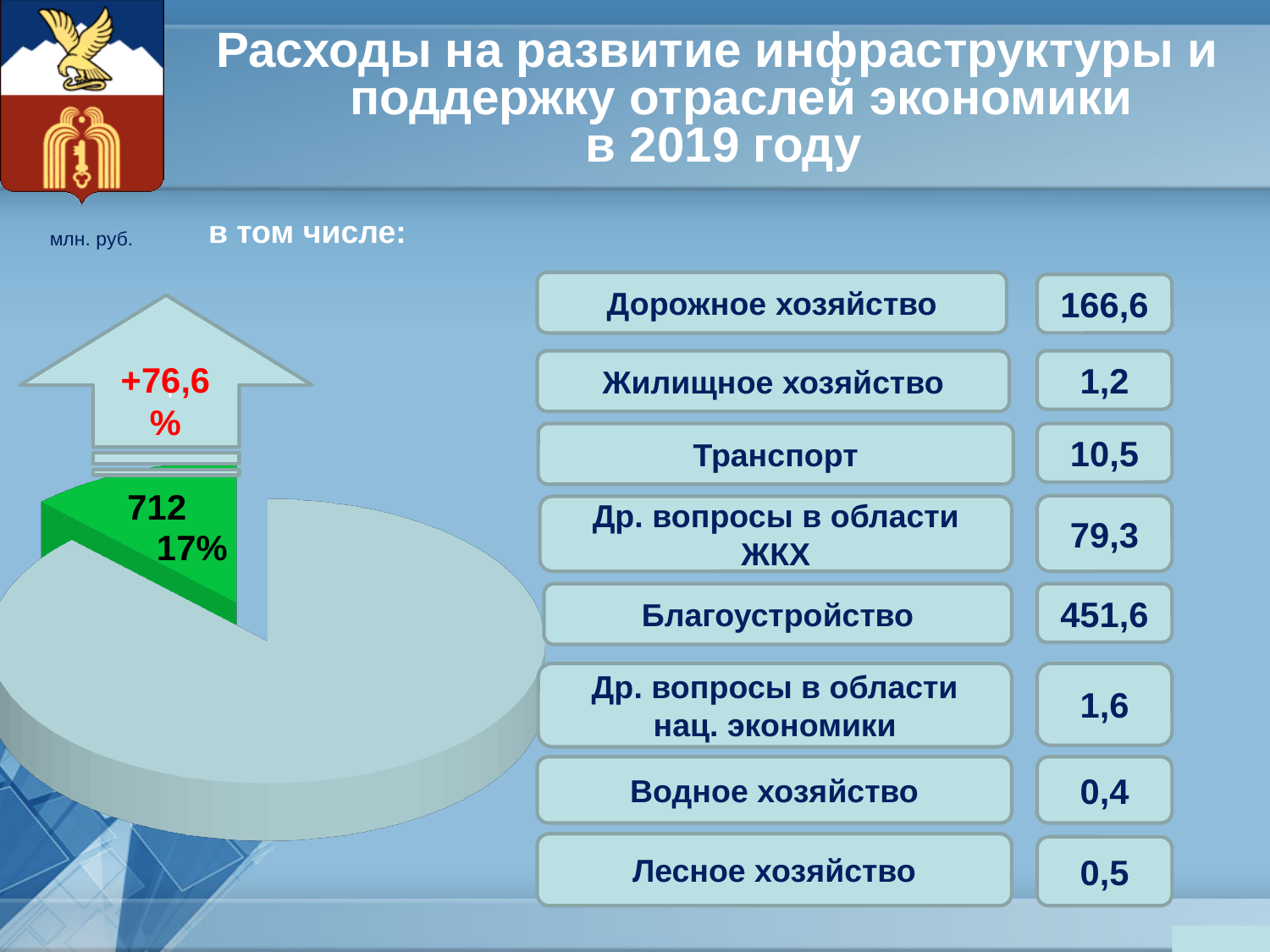
Is the share of the green slice greater or less than 50%? less In the breakdown next to the pie chart, what is the value for Благоустройство? 451,6 What percentage change is printed in red on the arrow above the pie chart? +76,6 % What value is printed on the green slice of the pie chart? 712 What share of the pie does the green slice represent? 17% How many slices does the pie chart have? 2 What unit is indicated for the values on the slide (top left)? млн. руб. In the breakdown next to the pie chart, which item has the highest value? Благоустройство In the breakdown next to the pie chart, which item has the lowest value? Водное хозяйство What kind of chart is shown on the slide? pie chart Which slice of the pie chart is larger, the green slice or the light blue slice? the light blue slice In the breakdown next to the pie chart, what is the value for Дорожное хозяйство? 166,6